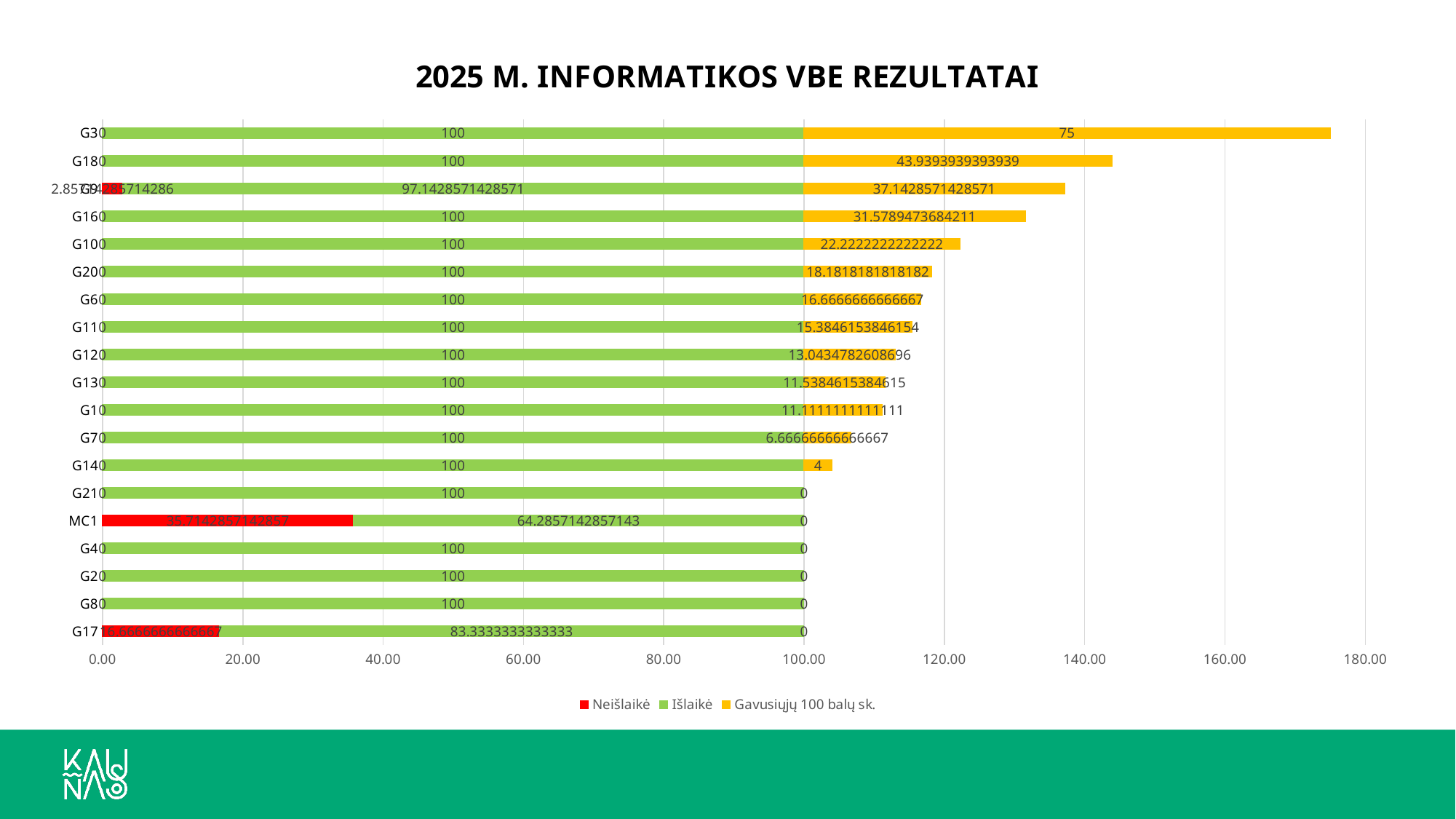
What is the total length of the stacked bar for G30? 175 What is the 'Išlaikė' value for G17? 83.3333333333333 What is the 'Neišlaikė' value for MC1? 35.7142857142857 Which has the larger 'Gavusiųjų 100 balų sk.' value, G180 or G160? G180 How many categories are shown on the y axis? 19 Is the total of the stacked bar for G180 greater or less than 140? greater What is the value of the 'Gavusiųjų 100 balų sk.' series for G30? 75 What is the value of the 'Gavusiųjų 100 balų sk.' series for G140? 4 Which category has the highest 'Gavusiųjų 100 balų sk.' value? G30 How many series does the legend list? 3 What is the difference between the 'Gavusiųjų 100 balų sk.' values for G30 and G140? 71 What type of chart is shown on the slide? Stacked bar chart